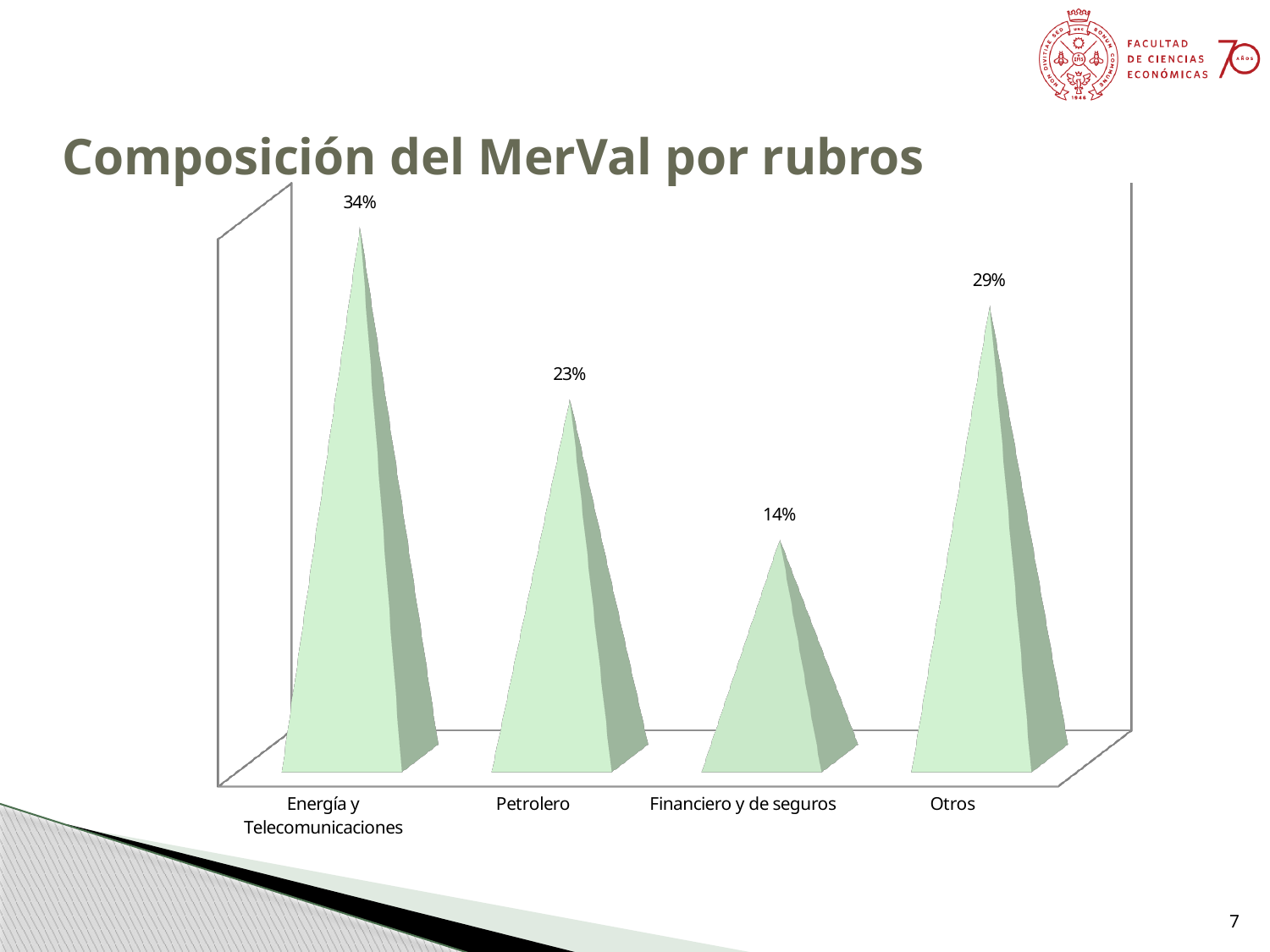
What is the value for Financiero y de seguros? 14% What is the value for Energía y Telecomunicaciones? 34% Which is larger, the value for Otros or the value for Petrolero? Otros What is the value for Otros? 29% What is the title of the slide? Composición del MerVal por rubros How many categories are shown in the chart? 4 What is the value for Petrolero? 23% What is the difference between the values for Energía y Telecomunicaciones and Petrolero? 11% What kind of chart is shown on the slide? Bar chart Which category has the highest value? Energía y Telecomunicaciones Which category has the lowest value? Financiero y de seguros What is the difference between the values for Otros and Financiero y de seguros? 15%